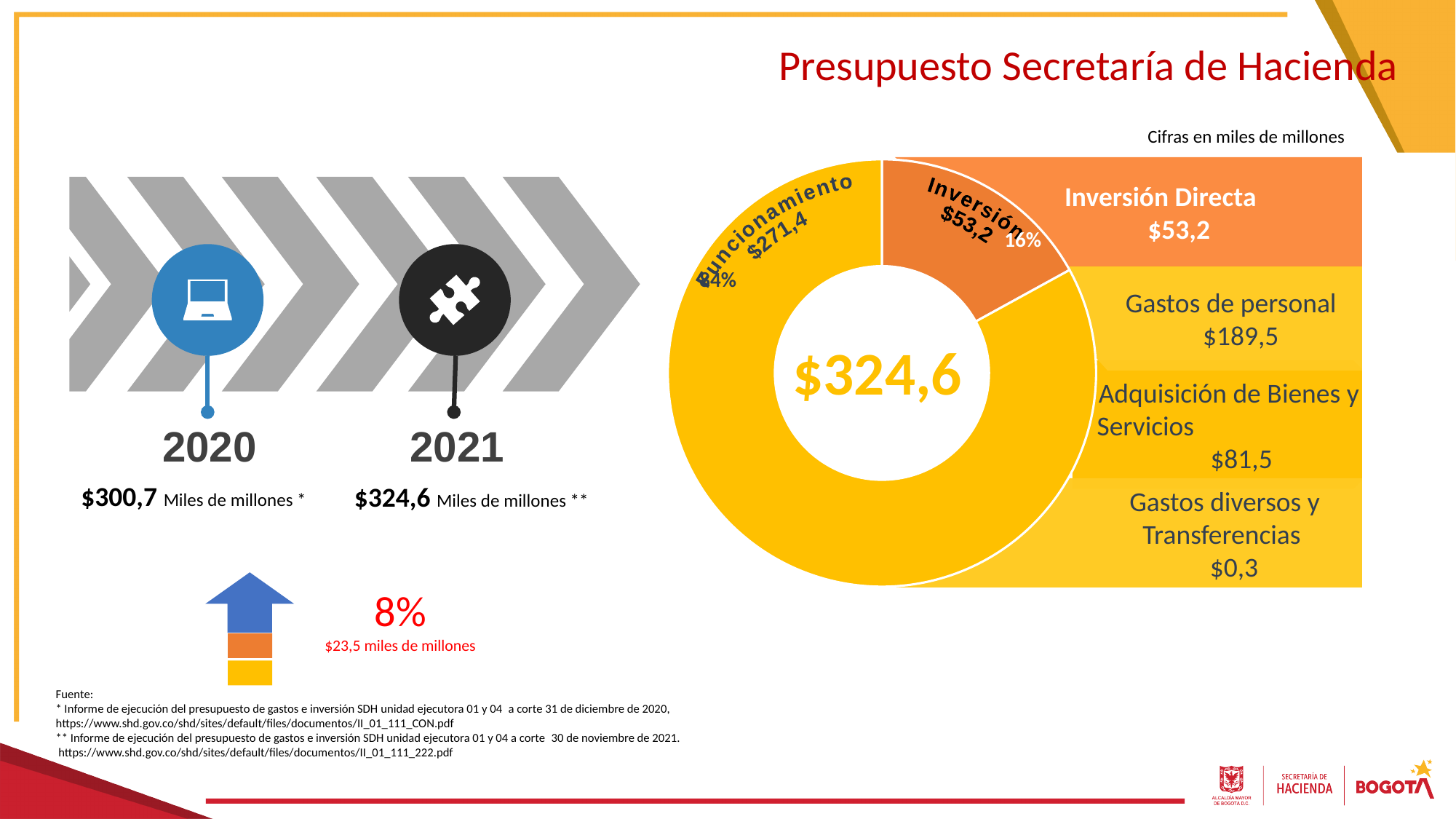
How many slices does the pie chart have? 2 What is the value of the Funcionamiento slice in the pie chart? $271,4 What is the value of the Inversión slice in the pie chart? $53,2 What total value is shown in the centre of the pie chart? $324,6 Which slice of the pie chart is the largest? Funcionamiento Which is larger in the pie chart, Funcionamiento or Inversión? Funcionamiento What colour is the Inversión slice of the pie chart? orange What kind of chart is shown on the right of the slide? doughnut chart Which slice of the pie chart is the smallest? Inversión What share of the pie chart does the Inversión slice represent? 16% What value is shown for Gastos de personal in the breakdown next to the pie chart? $189,5 What is the difference between the Funcionamiento and Inversión values in the pie chart? $218,2